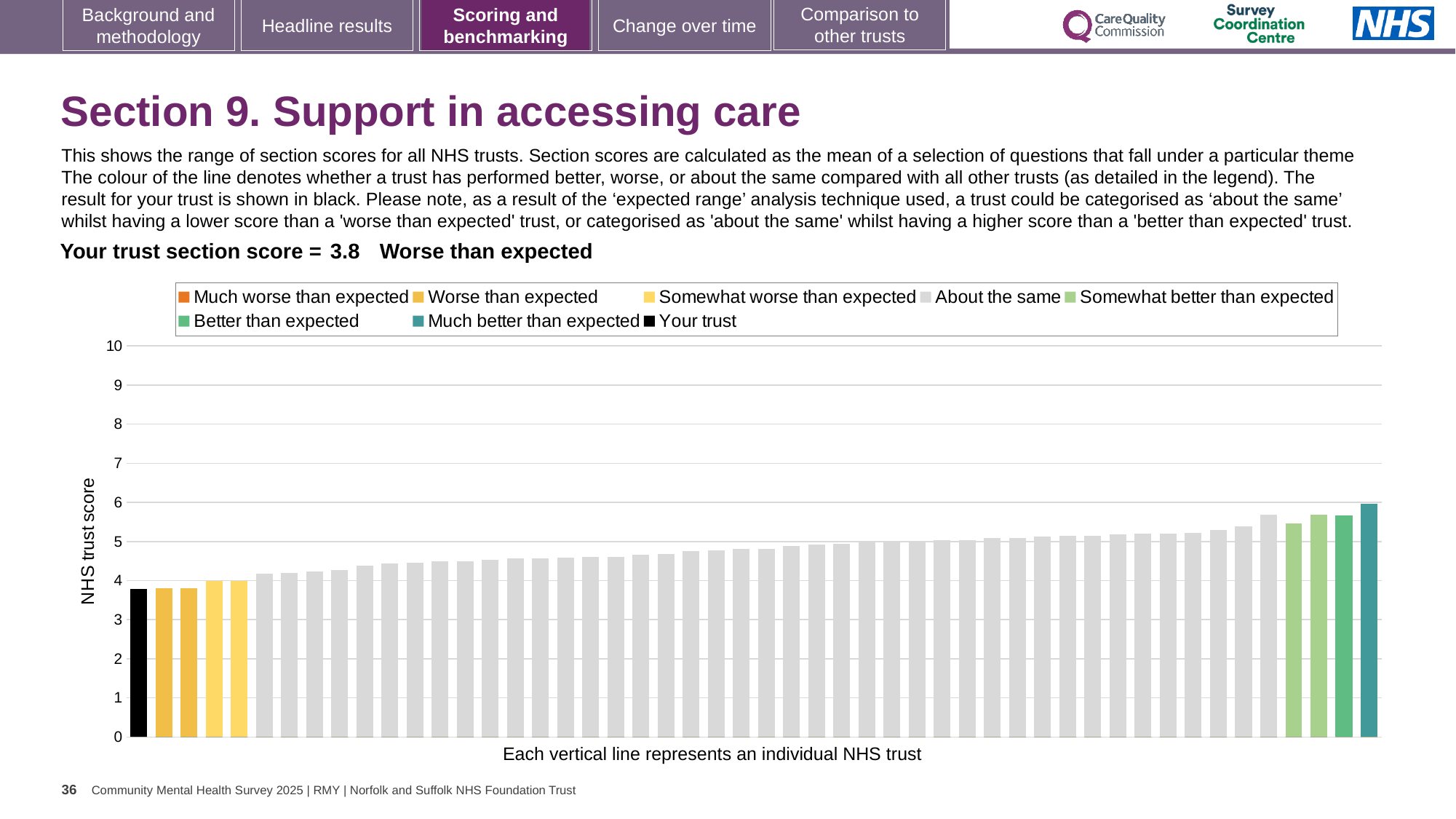
How many bars on the chart are black? 1 What is the label on the vertical axis of the chart? NHS trust score Do the bar values rise or fall from left to right along the x axis? rise Is the value of the highest bar on the chart greater or less than 7? less Is the value of the highest bar (the rightmost, teal bar) greater or less than 5? greater Is the value for your trust (the black bar) greater or less than 4? less How many entries does the chart legend list? 8 Which bar is larger, the leftmost (black) bar or the rightmost (teal) bar? the rightmost (teal) bar What colour is the bar representing your trust? black Which category is your trust's section score placed in, according to the slide? Worse than expected What kind of chart is shown on the slide? bar chart What is the section score for your trust shown on the slide? 3.8